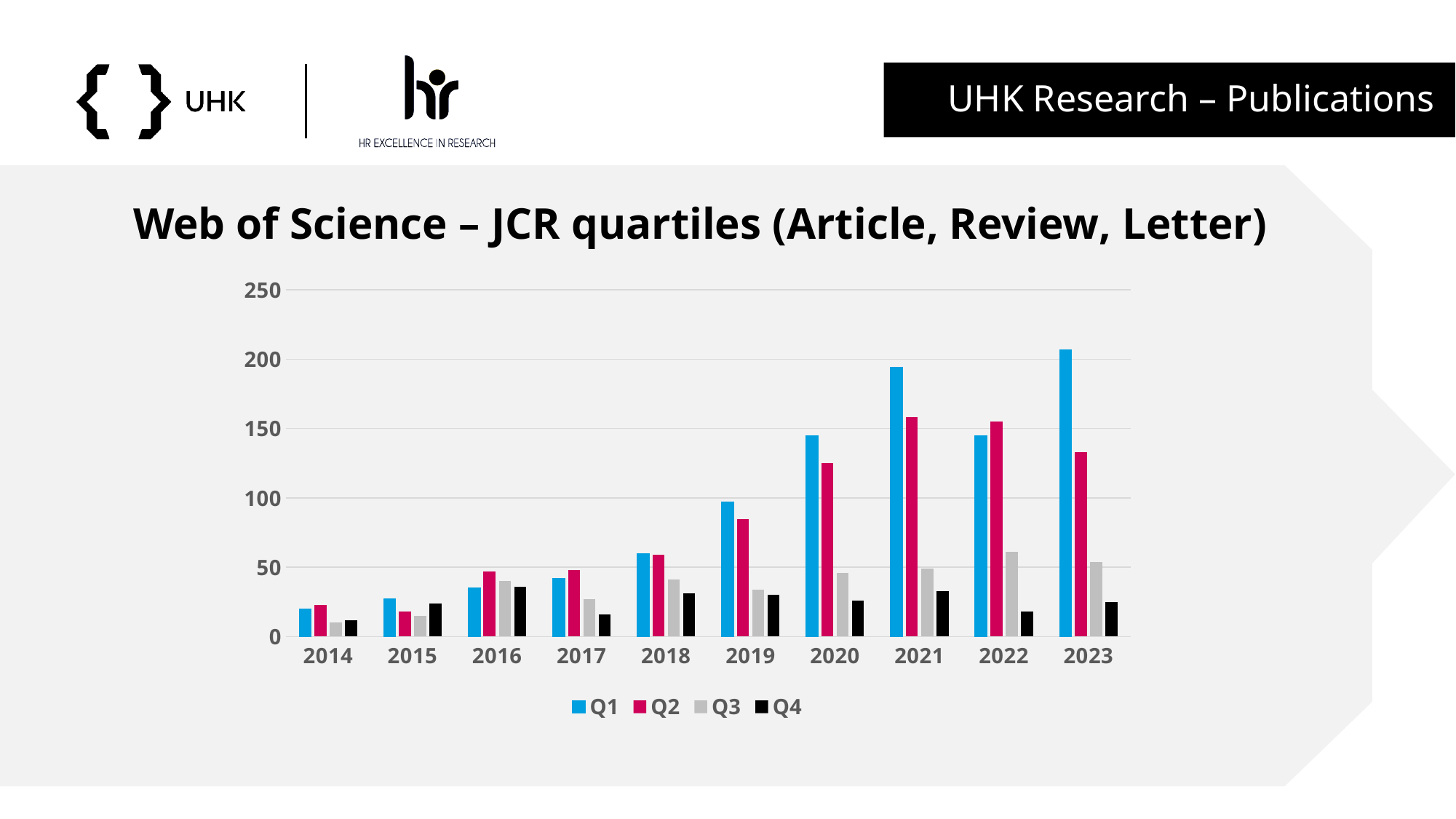
Do the Q1 values rise or fall from 2014 to 2021? rise Is the Q1 value for 2023 greater or less than 200? greater Is the Q2 value for 2021 greater or less than 150? greater How many series does the legend list? 4 In which year is the Q4 value lowest? 2014 In 2022, which is larger, Q1 or Q2? Q2 Is the Q3 value for 2022 greater or less than 50? greater In which year is the Q1 value highest? 2023 What colour represents Q1 in the legend? blue What kind of chart is shown on the slide? bar chart How many years are shown on the x axis? 10 In 2020, which is larger, Q1 or Q2? Q1